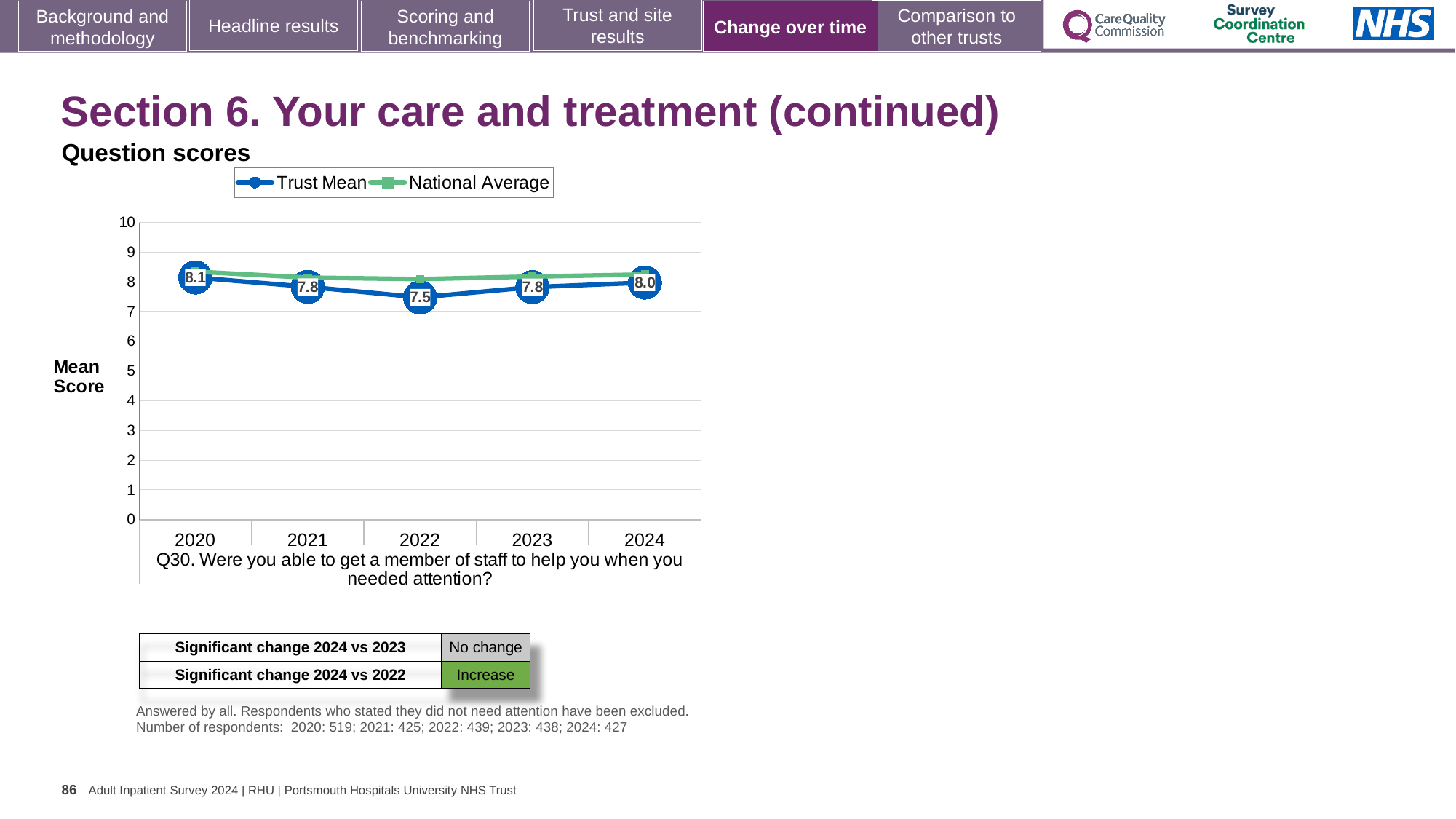
Which question does the chart show scores for? Q30. Were you able to get a member of staff to help you when you needed attention? What kind of chart is shown on the slide? Line chart How many series does the chart legend list? 2 Is the National Average value for 2022 greater or less than 7? greater How many years are shown on the x axis of the chart? 5 What is the Trust Mean score for 2022? 7.5 Which is larger, the Trust Mean score for 2024 or for 2023? 2024 What is the difference between the Trust Mean scores for 2020 and 2022? 0.6 What is the Trust Mean score for 2024? 8.0 In which year is the Trust Mean score lowest? 2022 What is the Trust Mean score for 2020? 8.1 In which year is the Trust Mean score highest? 2020